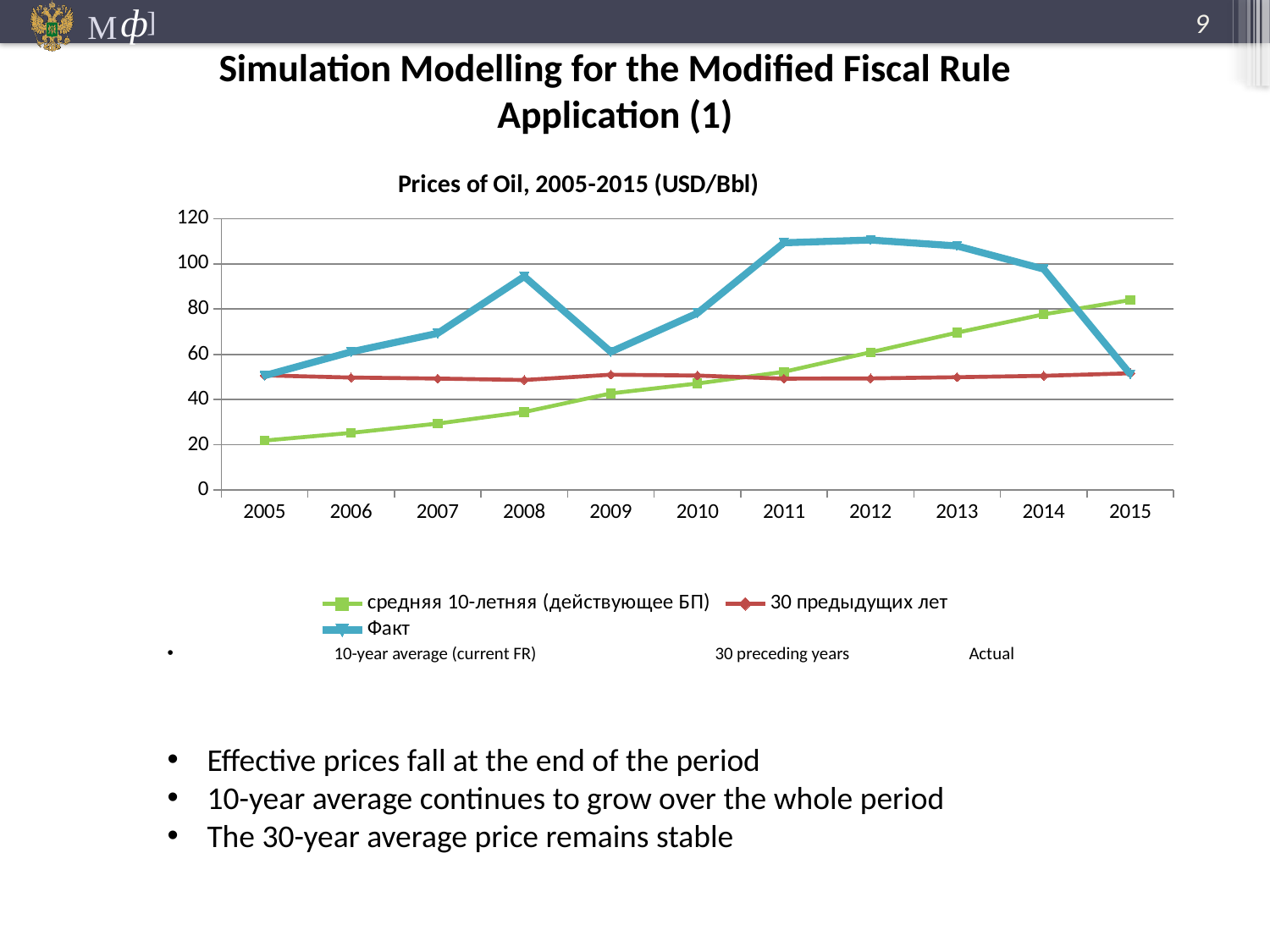
Is the Actual (Факт) value for 2012 greater or less than 100? greater In which year is the 10-year average (current FR) series lowest? 2005 Is the 10-year average (current FR) value for 2005 greater or less than 40? less In which year is the 10-year average (current FR) series highest? 2015 Is the Actual (Факт) value for 2008 greater or less than 80? greater What kind of chart is shown on the slide? line chart How many years are plotted along the x axis? 11 Does the 10-year average (current FR) series rise or fall from 2005 to 2015? rise In 2008, which is larger: the Actual (Факт) value or the 10-year average (current FR) value? Actual (Факт) How many series does the chart's legend list? 3 What is the title of the chart? Prices of Oil, 2005-2015 (USD/Bbl)